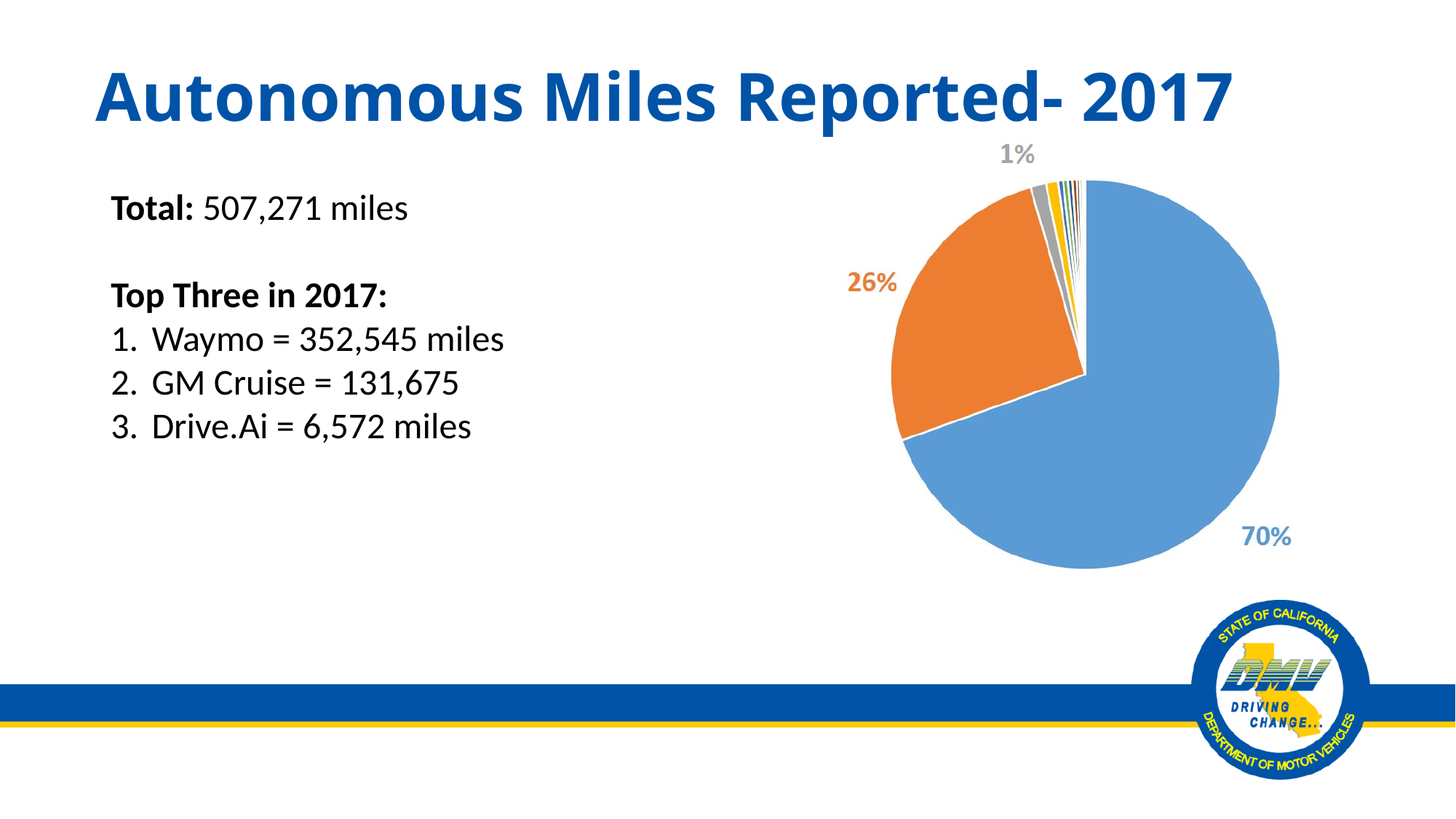
What is the difference in percentage points between the 70% slice and the 26% slice? 44% What colour is the largest slice of the pie chart? blue Is the share of the largest slice in the pie chart greater or less than 50%? greater What share of the pie chart does the second-largest (orange) slice represent? 26% Which slice of the pie chart is the largest, the blue one or the orange one? the blue one What kind of chart is shown on the slide? pie chart Is the share of the orange slice in the pie chart greater or less than 30%? less What share of the pie chart does the largest slice represent? 70% What is the title of the slide containing the pie chart? Autonomous Miles Reported- 2017 What is the largest percentage labelled on the pie chart? 70% What is the smallest percentage labelled on the pie chart? 1% What percentage is labelled on the small grey slice at the top of the pie chart? 1%